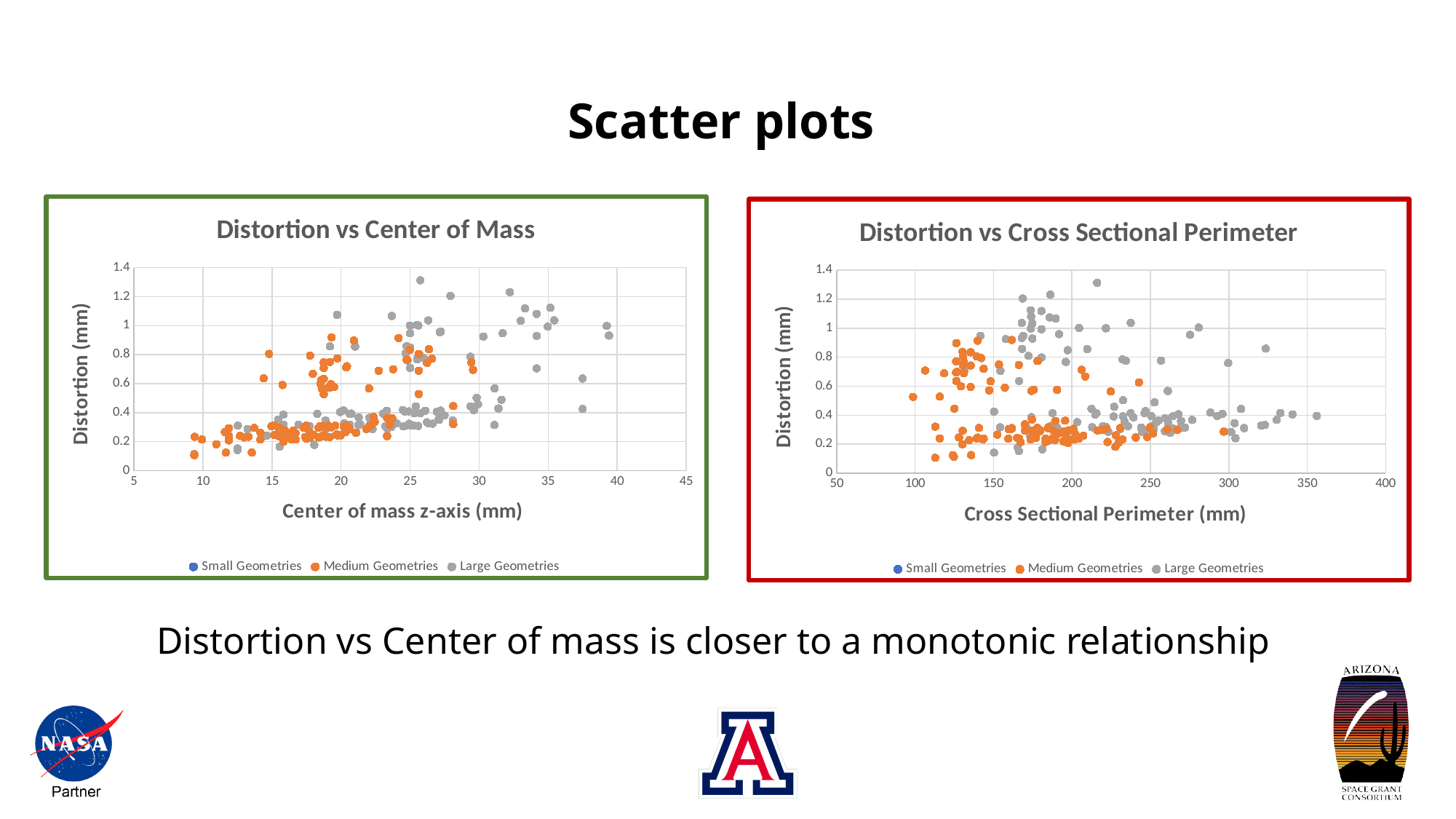
In the 'Distortion vs Center of Mass' chart, is the highest distortion value plotted greater or less than 1.2? greater In the 'Distortion vs Center of Mass' chart, does distortion generally rise or fall as center of mass z-axis increases? rise How many series does the legend of the 'Distortion vs Cross Sectional Perimeter' chart list? 3 In the 'Distortion vs Cross Sectional Perimeter' chart, is the largest cross sectional perimeter value for Large Geometries greater or less than 350? greater What kind of chart is the 'Distortion vs Center of Mass' chart? scatter plot In the 'Distortion vs Center of Mass' chart, is the largest center of mass z-axis value for Medium Geometries greater or less than 35? less How many series does the legend of the 'Distortion vs Center of Mass' chart list? 3 How many charts are shown on the slide? 2 What is the x-axis label of the 'Distortion vs Cross Sectional Perimeter' chart? Cross Sectional Perimeter (mm) Which legend entry in the 'Distortion vs Center of Mass' chart is shown in orange? Medium Geometries What kind of chart is the 'Distortion vs Cross Sectional Perimeter' chart? scatter plot